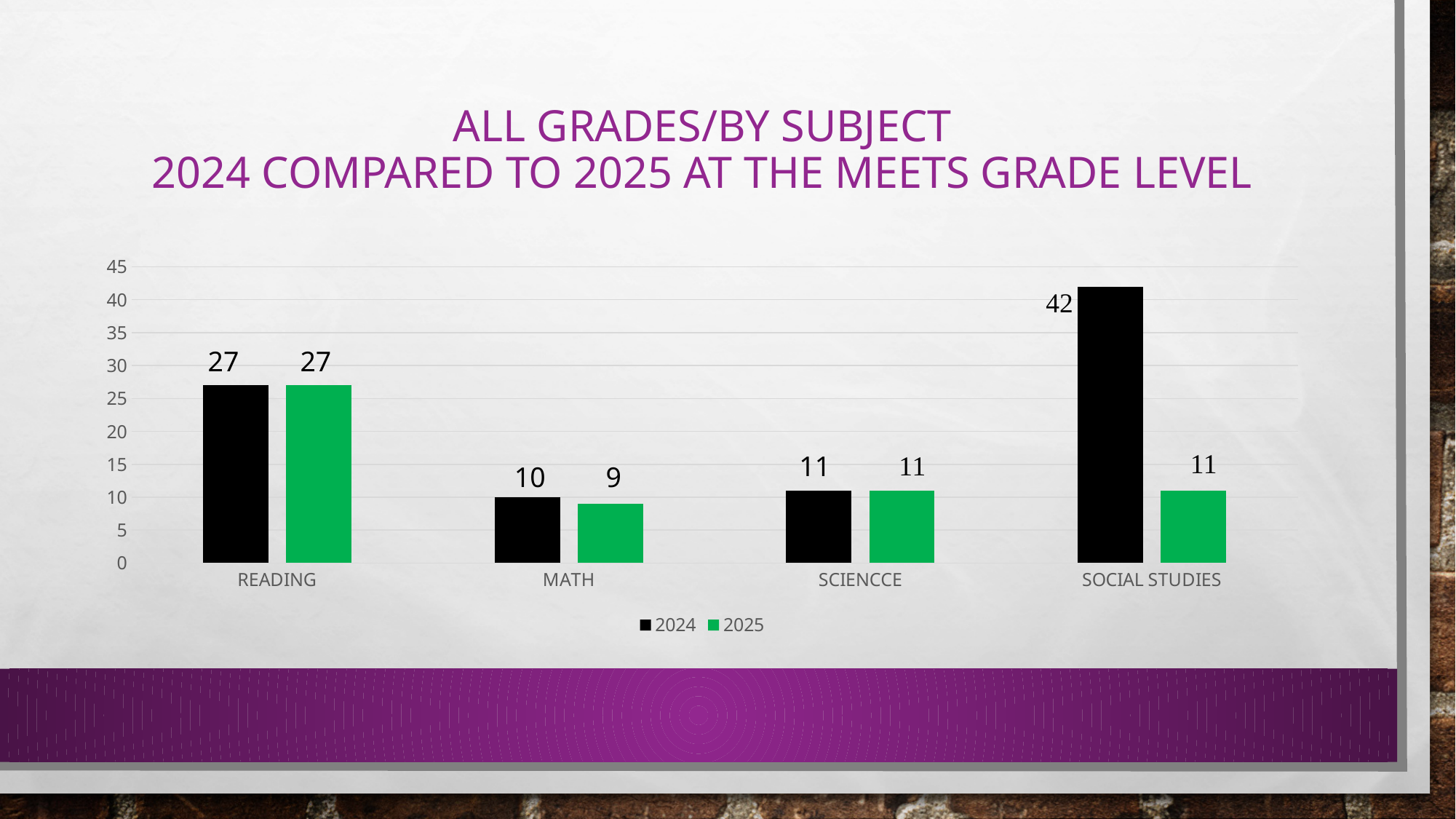
What colour are the bars for the 2025 series? Green What is the 2024 value for Reading? 27 What is the difference between the 2024 and 2025 values for Math? 1 What is the 2025 value for Math? 9 What kind of chart is shown on the slide? Bar chart Which subject has the highest 2024 value? Social Studies What is the difference between the 2024 and 2025 values for Social Studies? 31 What is the 2024 value for Social Studies? 42 Which subject has the lowest 2025 value? Math Which is larger for Math: the 2024 value or the 2025 value? 2024 How many subjects are shown on the x axis? 4 How many series does the legend list? 2